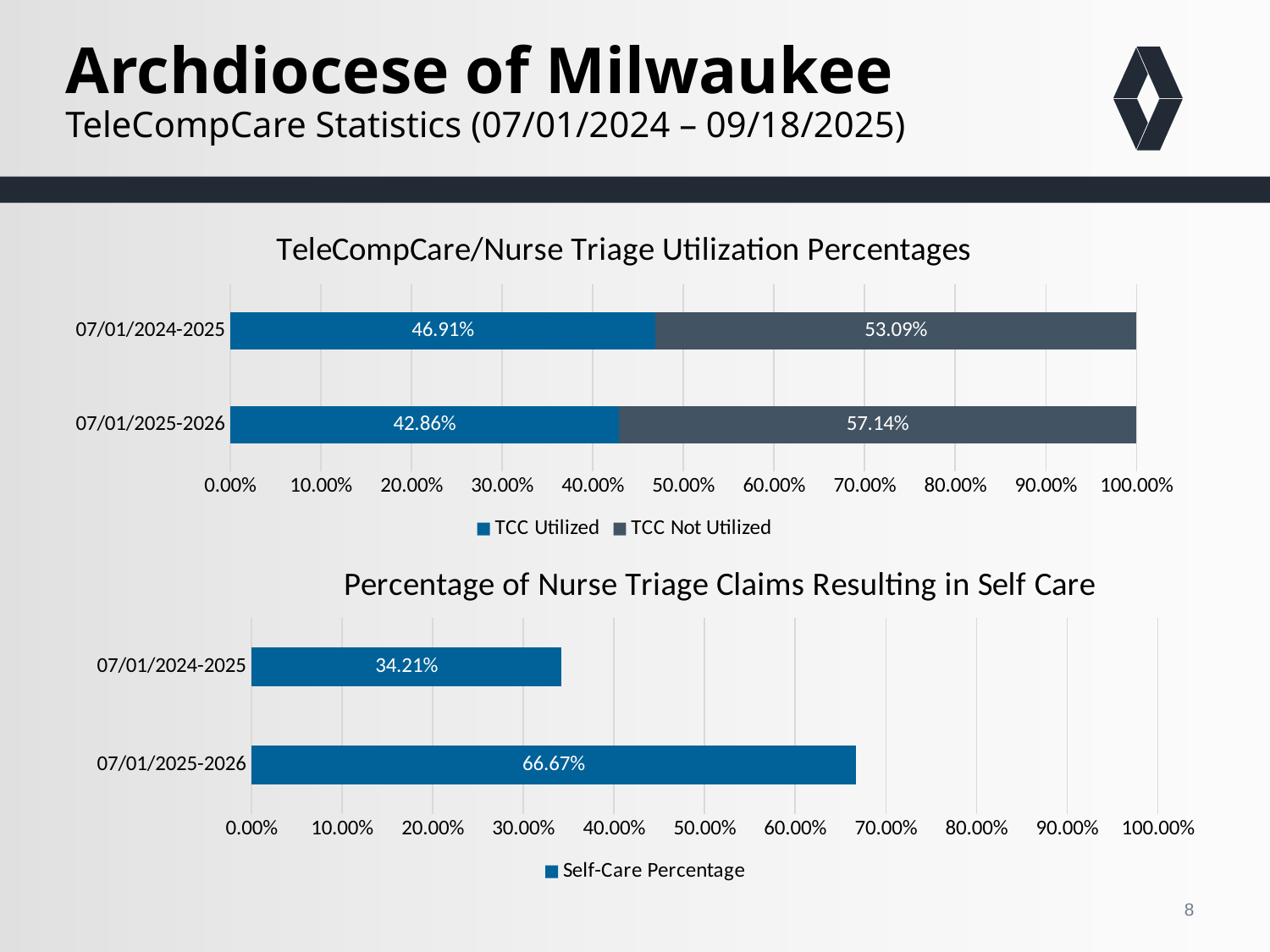
In the 'Percentage of Nurse Triage Claims Resulting in Self Care' chart, which period has the lowest self-care percentage? 07/01/2024-2025 In the 'Percentage of Nurse Triage Claims Resulting in Self Care' chart, what is the difference between the 07/01/2025-2026 and 07/01/2024-2025 values? 32.46% In the 'TeleCompCare/Nurse Triage Utilization Percentages' chart, which period has the higher TCC Utilized value? 07/01/2024-2025 In the 'TeleCompCare/Nurse Triage Utilization Percentages' chart, what is the TCC Not Utilized value for 07/01/2025-2026? 57.14% In the 'Percentage of Nurse Triage Claims Resulting in Self Care' chart, what is the value for 07/01/2025-2026? 66.67% What kind of chart is the 'Percentage of Nurse Triage Claims Resulting in Self Care' chart? Bar chart In the 'TeleCompCare/Nurse Triage Utilization Percentages' chart, what is the difference between the TCC Not Utilized values for 07/01/2025-2026 and 07/01/2024-2025? 4.05% In the 'TeleCompCare/Nurse Triage Utilization Percentages' chart, what is the total of the stacked bar for 07/01/2024-2025? 100.00% In the 'TeleCompCare/Nurse Triage Utilization Percentages' chart, how many series does the legend list? 2 In the 'Percentage of Nurse Triage Claims Resulting in Self Care' chart, is the value for 07/01/2024-2025 greater or less than 40.00%? less In the 'Percentage of Nurse Triage Claims Resulting in Self Care' chart, how many categories are shown? 2 In the 'TeleCompCare/Nurse Triage Utilization Percentages' chart, what is the TCC Utilized value for 07/01/2024-2025? 46.91%